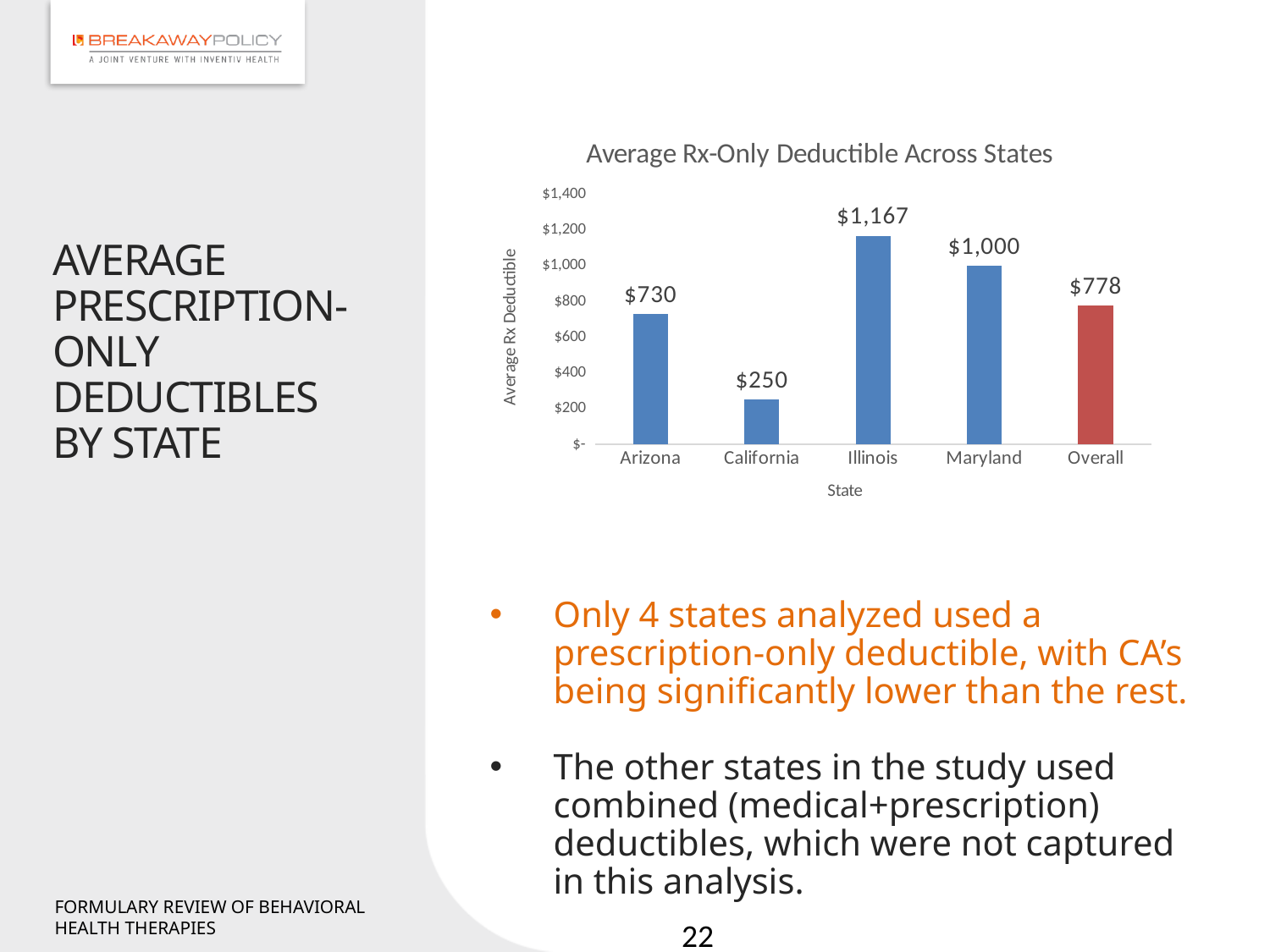
What type of chart is shown on the slide? Bar chart Which state has the highest average Rx-only deductible? Illinois Which bar on the chart is coloured red rather than blue? Overall What is the Overall average Rx-only deductible shown on the chart? $778 What is the average Rx-only deductible for Illinois? $1,167 What is the difference between the average Rx-only deductible for Maryland and Arizona? $270 How many bars are shown on the chart? 5 What is the average Rx-only deductible for California? $250 Is the value for Arizona greater or less than $800? less Which has a larger average Rx-only deductible, Arizona or Maryland? Maryland Which state has the lowest average Rx-only deductible? California What is the title of the chart? Average Rx-Only Deductible Across States